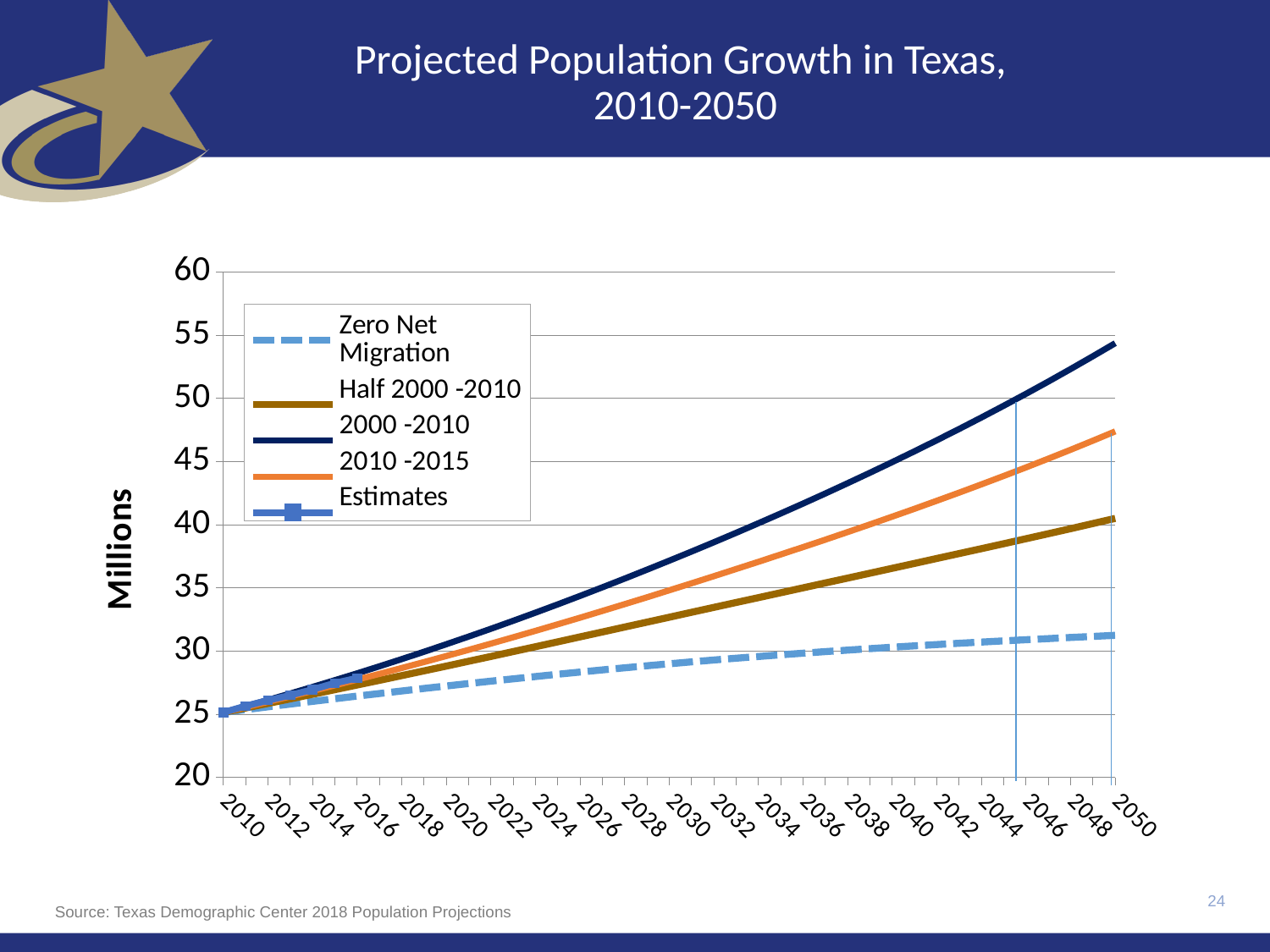
What is the title of the chart? Projected Population Growth in Texas, 2010-2050 Is the value for the 2000 -2010 series in 2050 greater or less than 50? greater Is the value for the Half 2000 -2010 series in 2050 greater or less than 45? less In 2050, which is larger: the 2010 -2015 series or the Half 2000 -2010 series? 2010 -2015 What is the label on the vertical axis? Millions What kind of chart is shown on the slide? line chart Is the value for the Zero Net Migration series in 2050 greater or less than 35? less Do the values of the 2000 -2010 series rise or fall from 2010 to 2050? rise Which series reaches the highest value in 2050? 2000 -2010 How many series does the legend list? 5 Which series has the lowest value in 2050? Zero Net Migration